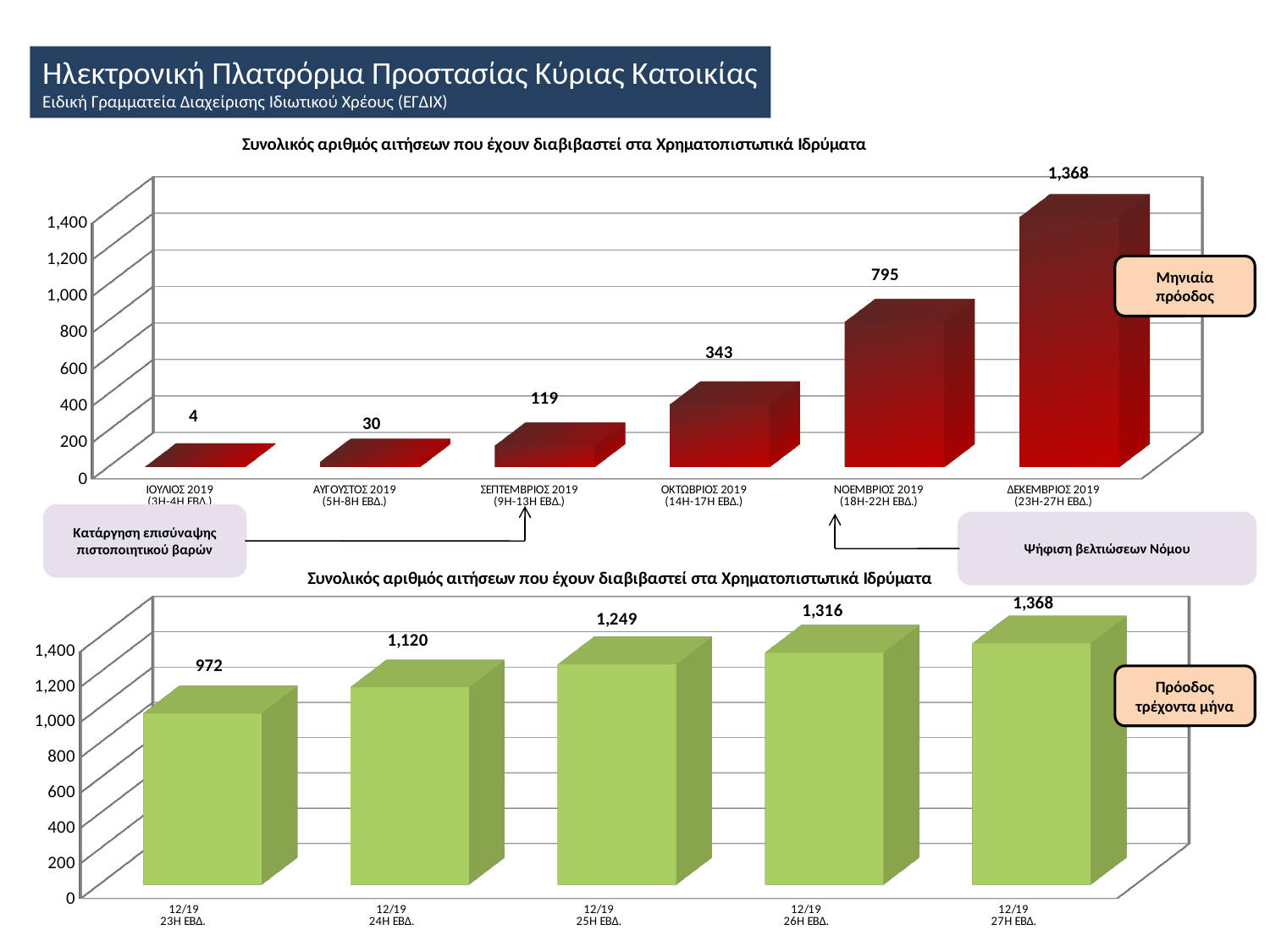
On the top chart (red bars), how many months are shown? 6 On the bottom chart (green bars), what is the value for 12/19 24Η ΕΒΔ.? 1,120 On the top chart (red bars), do the values rise or fall from ΙΟΥΛΙΟΣ 2019 to ΔΕΚΕΜΒΡΙΟΣ 2019? rise On the top chart (red bars), what is the value for ΟΚΤΩΒΡΙΟΣ 2019? 343 On the bottom chart (green bars), how many bars are shown? 5 On the top chart (red bars), what is the value for ΔΕΚΕΜΒΡΙΟΣ 2019? 1,368 On the top chart (red bars), which month has the lowest value? ΙΟΥΛΙΟΣ 2019 On the bottom chart (green bars), what is the difference between the values for 12/19 25Η ΕΒΔ. and 12/19 23Η ΕΒΔ.? 277 On the bottom chart (green bars), which week has the highest value? 12/19 27Η ΕΒΔ. What type of chart is the bottom chart (green bars)? bar chart On the top chart (red bars), what is the difference between the values for ΝΟΕΜΒΡΙΟΣ 2019 and ΟΚΤΩΒΡΙΟΣ 2019? 452 On the bottom chart (green bars), which is larger: the value for 12/19 26Η ΕΒΔ. or 12/19 24Η ΕΒΔ.? 12/19 26Η ΕΒΔ.